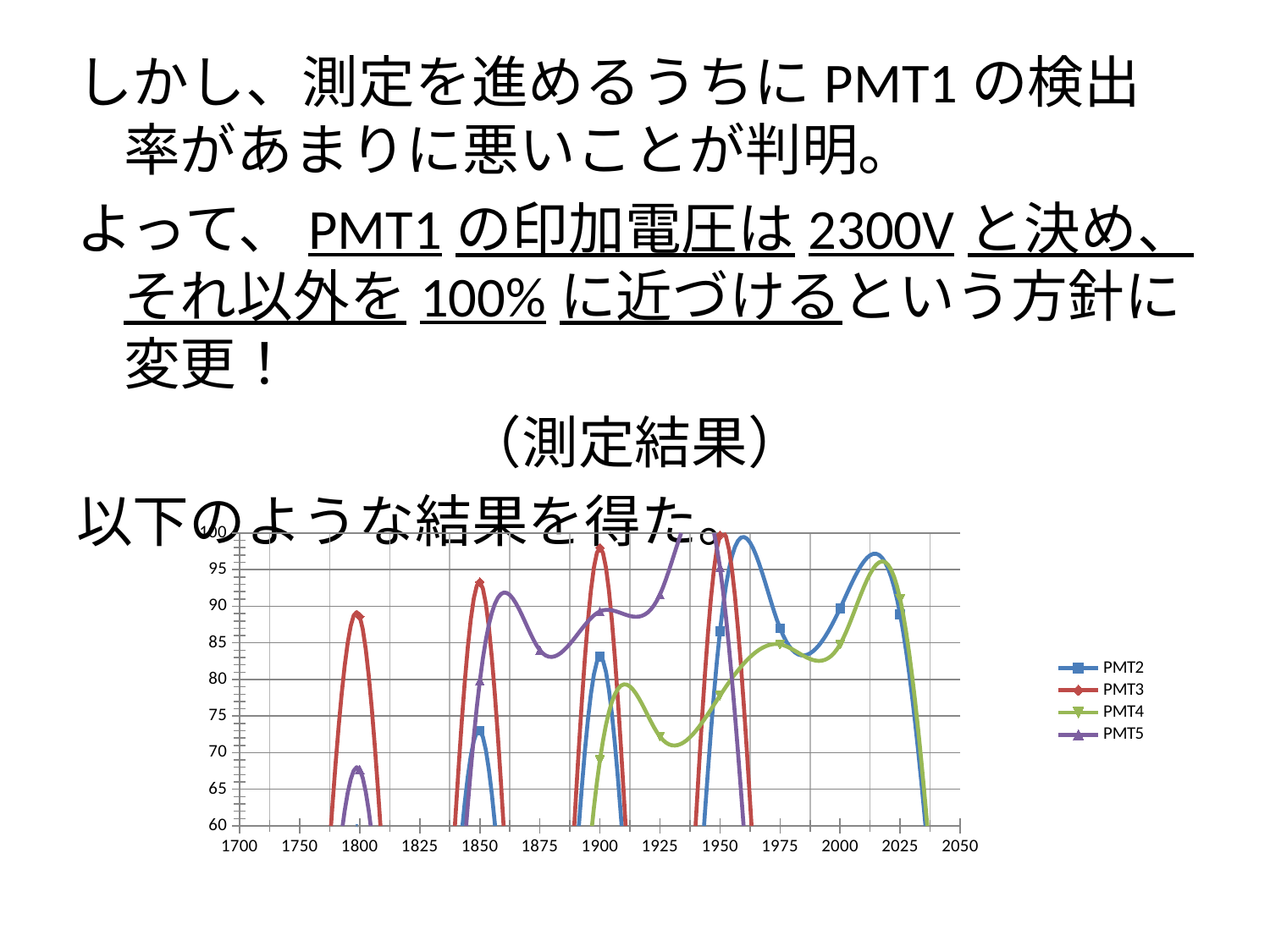
What kind of chart is shown on the slide? line chart How many series does the legend list? 4 At 1900, which is larger, the value for PMT3 or the value for PMT4? PMT3 Which series are listed in the legend? PMT2, PMT3, PMT4, PMT5 At 1800, which is larger, the value for PMT3 or the value for PMT5? PMT3 Is the value for PMT4 at 1950 greater or less than 80? less Is the value for PMT5 at 1800 greater or less than 70? less At 1950, which is larger, the value for PMT3 or the value for PMT4? PMT3 Is the value for PMT3 at 1900 greater or less than 95? greater